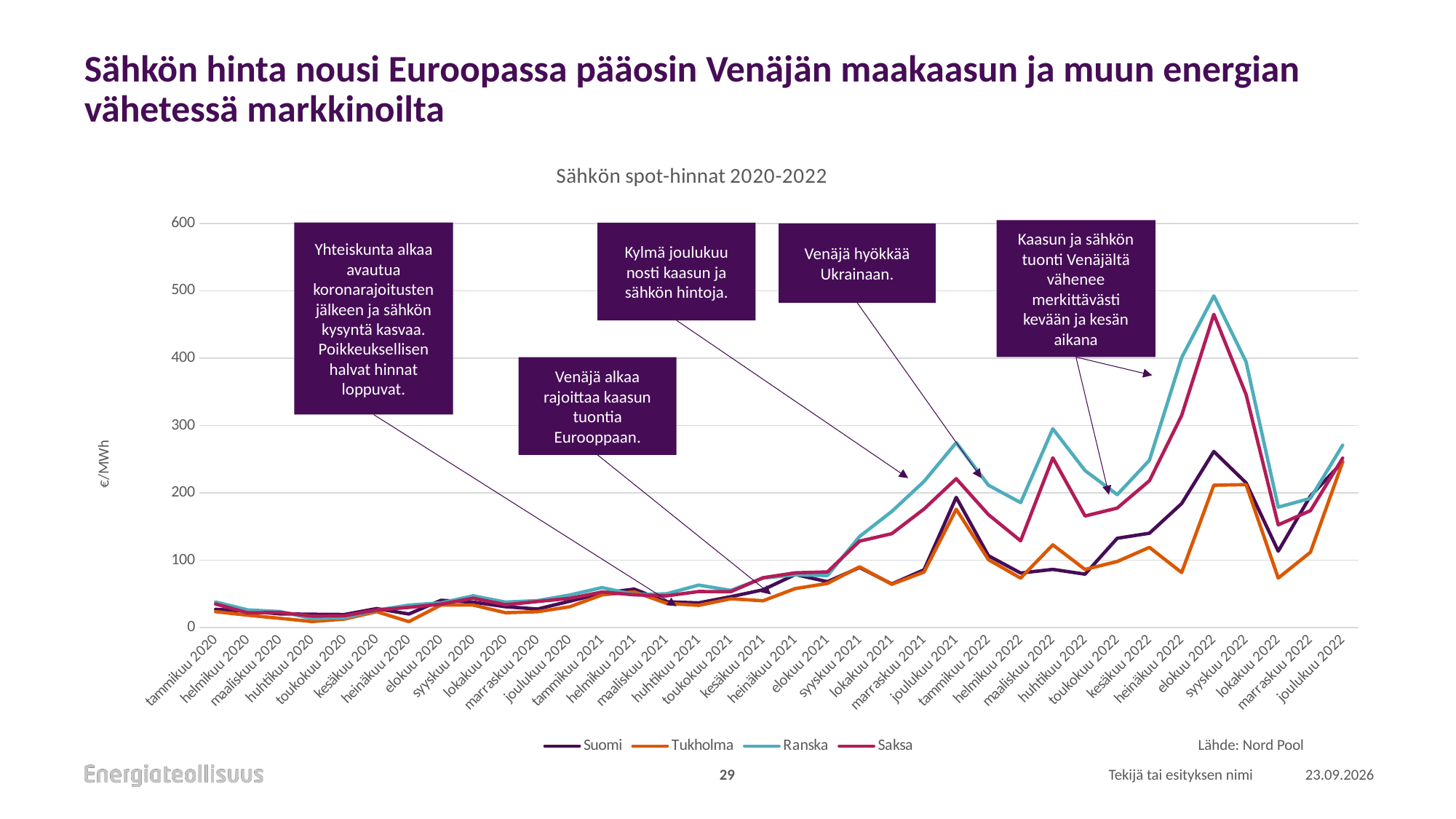
Which series reaches the highest value on the chart? Ranska Is the value for Ranska in elokuu 2022 greater or less than 400? greater What kind of chart is shown on the slide? line chart Is the value for Tukholma in lokakuu 2022 greater or less than 100? less Which series are listed in the legend? Suomi, Tukholma, Ranska, Saksa Do the values for Saksa generally rise or fall from tammikuu 2020 to elokuu 2022? rise Which is larger in maaliskuu 2022, the value for Ranska or the value for Suomi? Ranska How many months (data points) are shown along the x axis? 36 In which month does the Ranska series reach its peak? elokuu 2022 What is the title of the chart? Sähkön spot-hinnat 2020-2022 Is the value for Suomi in elokuu 2022 greater or less than 300? less How many series does the legend list? 4